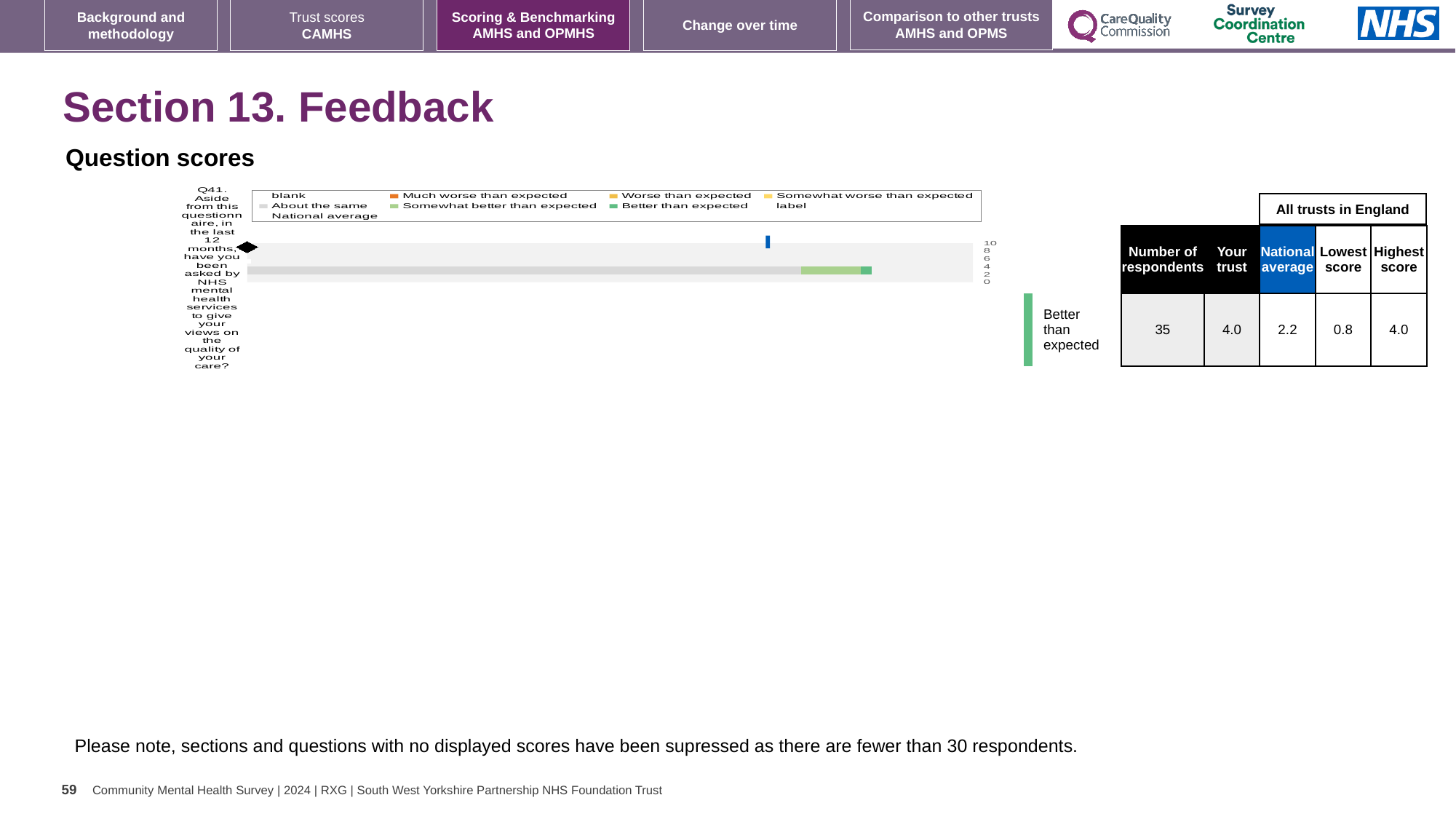
What benchmark rating is shown beside the chart for Q41? Better than expected According to the table beside the chart, what is the 'Your trust' score for Q41? 4.0 According to the table beside the chart, what is the national average score for Q41? 2.2 For Q41, what is the difference between the highest score and the lowest score among all trusts in England? 3.2 How many survey questions are plotted in the chart on the slide? 1 What kind of chart is shown for Q41 on the slide? bar chart According to the table beside the chart, what is the highest score among all trusts in England for Q41? 4.0 How many respondents answered Q41, according to the table beside the chart? 35 For Q41, which is larger: the 'Your trust' score or the national average? Your trust For Q41, what is the difference between the 'Your trust' score and the national average? 1.8 Which question number is plotted in the chart? Q41 According to the table beside the chart, what is the lowest score among all trusts in England for Q41? 0.8